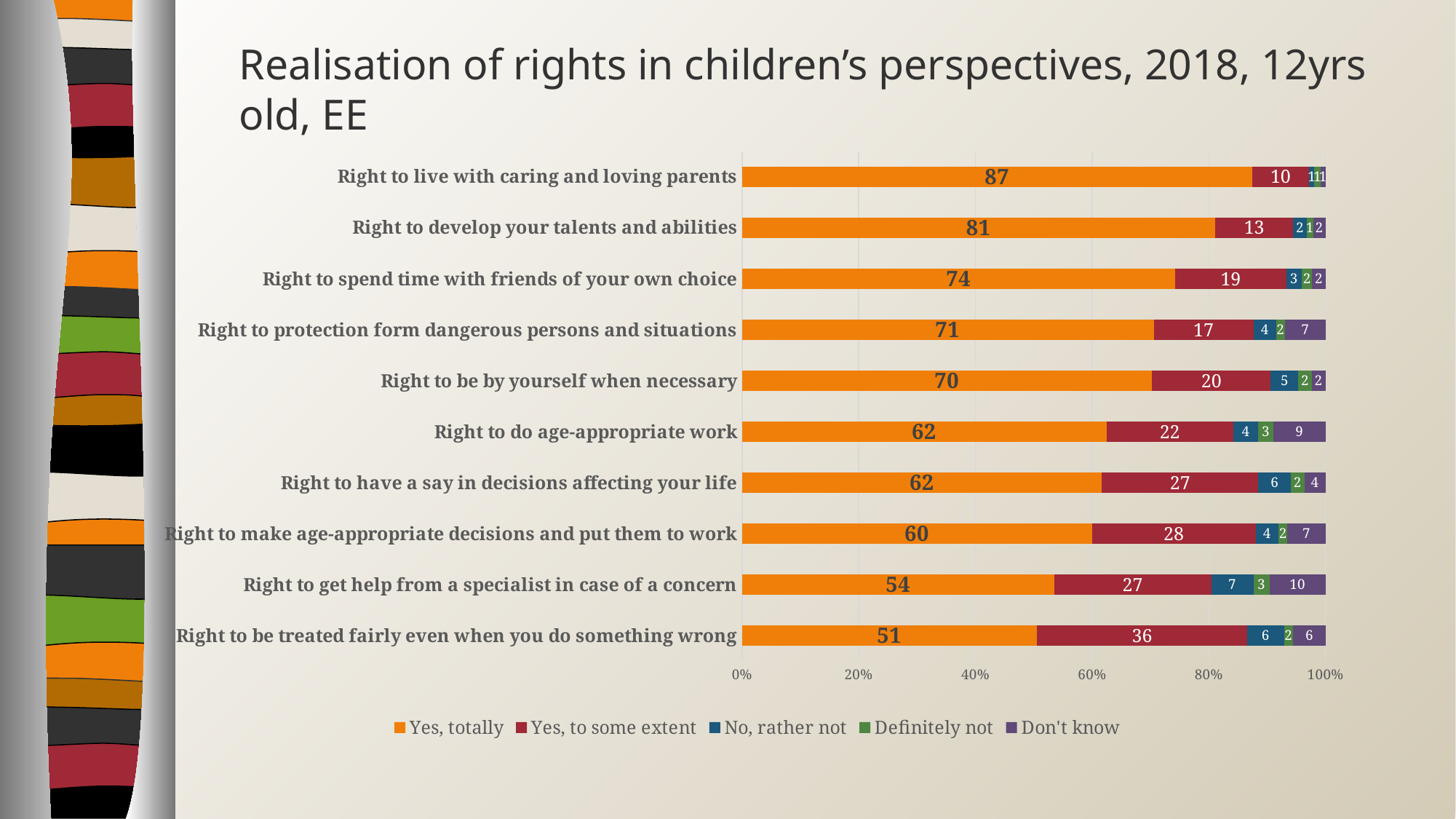
What is the difference between the "Yes, totally" values for "Right to develop your talents and abilities" and "Right to get help from a specialist in case of a concern"? 27 Which legend entry is shown in orange? Yes, totally Which category has the lowest "Yes, totally" value? Right to be treated fairly even when you do something wrong What kind of chart is shown on the slide? Stacked bar chart What is the "Don't know" value for "Right to get help from a specialist in case of a concern"? 10 Which has a larger "Yes, to some extent" value: "Right to do age-appropriate work" or "Right to make age-appropriate decisions and put them to work"? Right to make age-appropriate decisions and put them to work What is the "Yes, to some extent" value for "Right to be treated fairly even when you do something wrong"? 36 Which category has the highest "Yes, totally" value? Right to live with caring and loving parents What is the "Yes, totally" value for "Right to live with caring and loving parents"? 87 How many series does the legend list? 5 What is the "No, rather not" value for "Right to be by yourself when necessary"? 5 How many categories (rights) are shown on the chart? 10